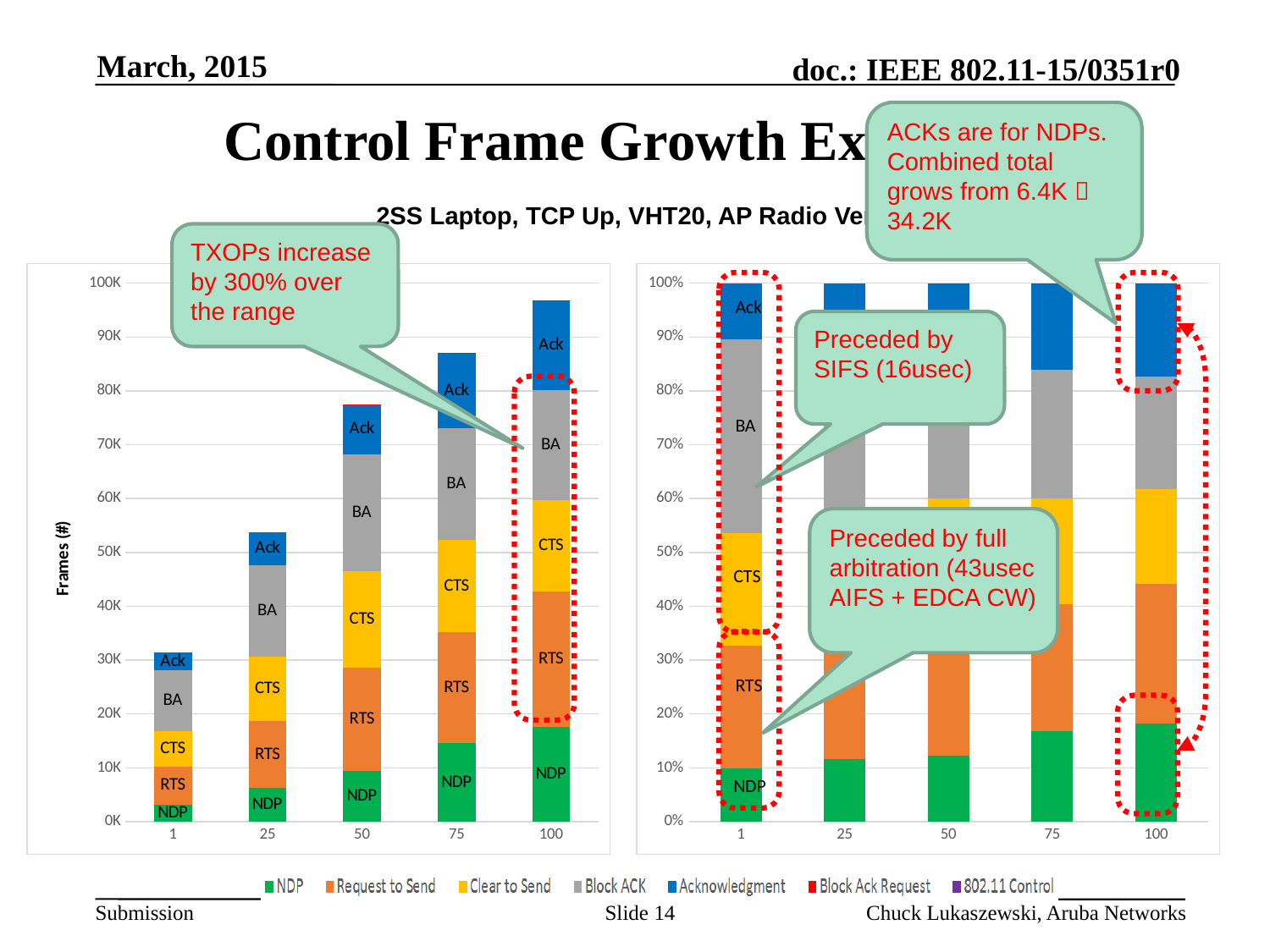
In the left chart, do the total bar heights rise or fall as the x-axis value increases from 1 to 100? rise Which legend entry is shown in green? NDP How many series does the legend at the bottom of the slide list? 7 What is the label on the y axis of the left chart? Frames (#) In the right chart, is the NDP share for category 100 greater or less than 10%? greater In the left chart, which x-axis category has the shortest stacked bar? 1 In the right chart, is the NDP share larger for category 1 or for category 100? 100 What kind of chart is the left chart (Frames (#))? stacked bar chart In the left chart, is the total height of the bar for category 100 greater or less than 90K? greater In the left chart, is the total height of the bar for category 1 greater or less than 40K? less In the left chart, which x-axis category has the tallest stacked bar? 100 How many categories are shown on the x axis of the left chart? 5